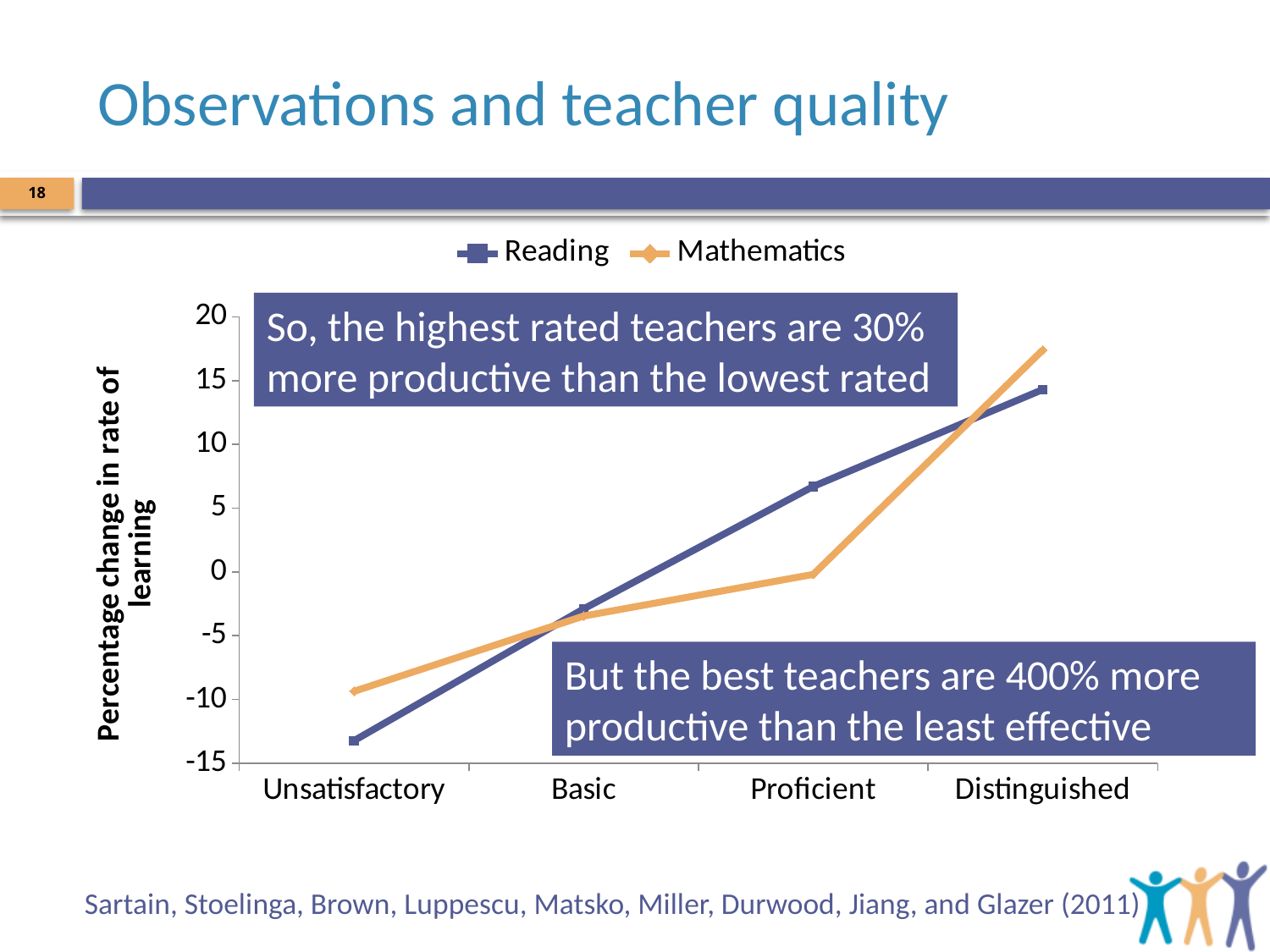
At Proficient, which series has the higher value, Reading or Mathematics? Reading What is the title of the vertical axis? Percentage change in rate of learning Do the Reading values rise or fall from Unsatisfactory to Distinguished? rise How many rating categories are shown on the x axis? 4 For which category is the Reading value highest? Distinguished For which category is the Mathematics value lowest? Unsatisfactory Is the Reading value for Unsatisfactory greater or less than -10? less How many series does the legend list? 2 What kind of chart is shown on the slide? line chart Is the Mathematics value for Distinguished greater or less than 15? greater At Distinguished, which series has the higher value, Reading or Mathematics? Mathematics Which series are listed in the legend? Reading and Mathematics